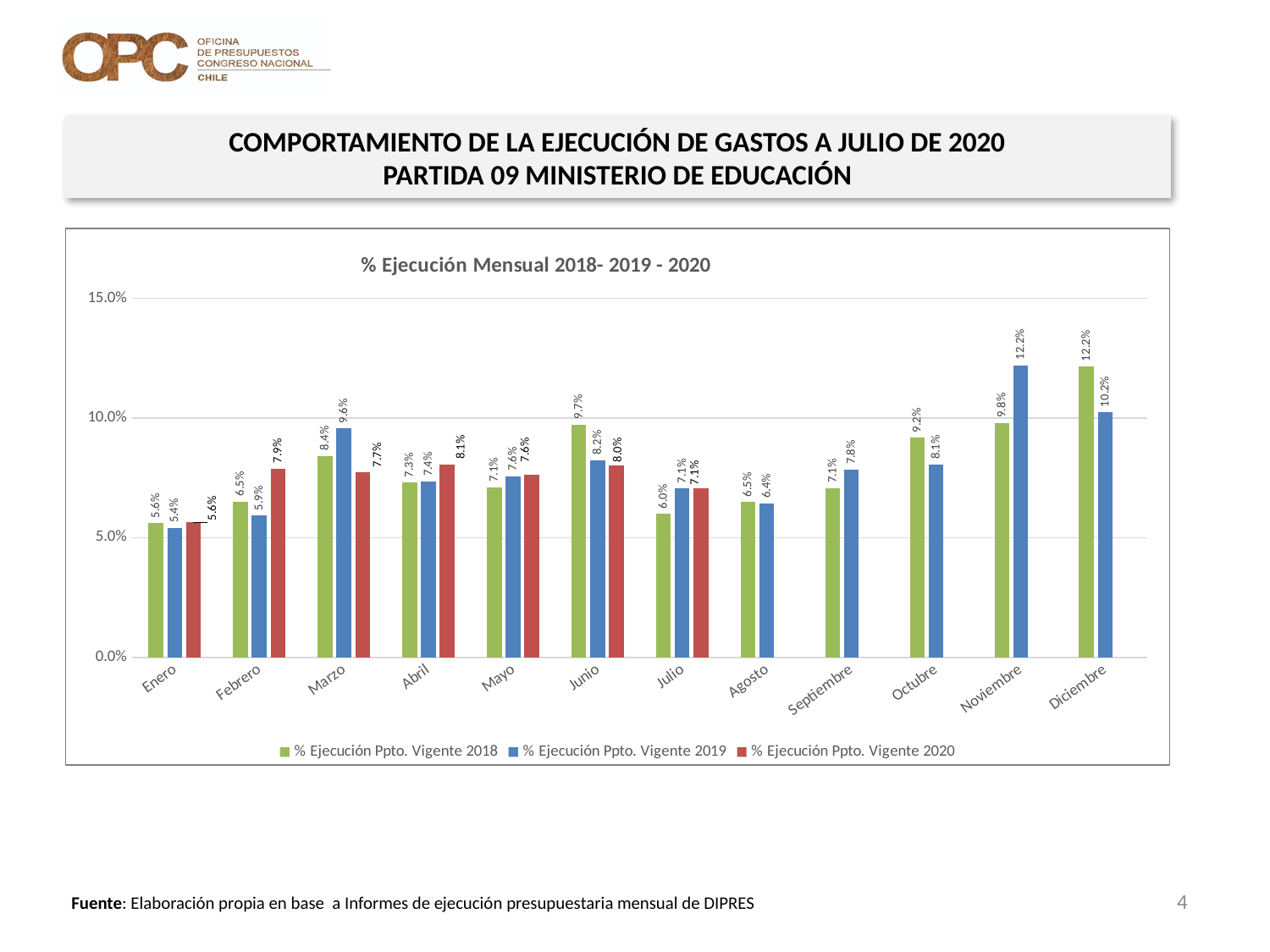
What is the difference between the 2019 and 2018 values for Noviembre? 2.4% Which is larger for Junio: the 2018 value or the 2019 value? 2018 value Which month has the highest value for % Ejecución Ppto. Vigente 2019? Noviembre What is the title of the chart? % Ejecución Mensual 2018- 2019 - 2020 What is the value of % Ejecución Ppto. Vigente 2019 for Marzo? 9.6% What kind of chart is shown on the slide? Bar chart What is the value of % Ejecución Ppto. Vigente 2018 for Diciembre? 12.2% What is the value of % Ejecución Ppto. Vigente 2020 for Julio? 7.1% What is the value of % Ejecución Ppto. Vigente 2020 for Febrero? 7.9% Which month has the lowest value for % Ejecución Ppto. Vigente 2018? Enero How many series does the legend list? 3 How many months are shown on the x axis? 12